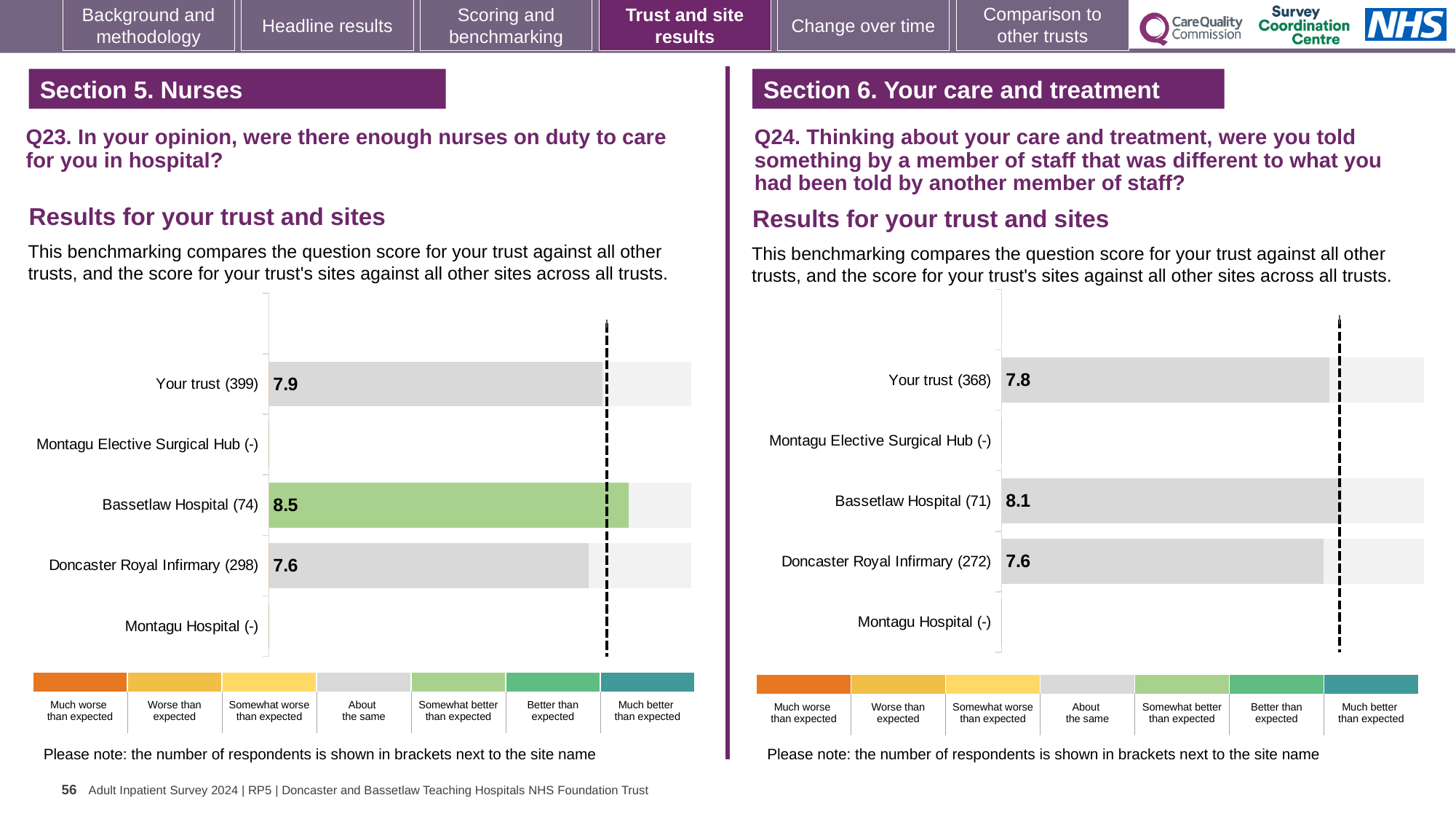
On the Q24 chart (right), what is the difference between the Your trust score and the Bassetlaw Hospital score? 0.3 On the Q23 chart (left), what is the score for Bassetlaw Hospital? 8.5 On the Q24 chart (right), which site has the lowest score among those with a value shown? Doncaster Royal Infirmary On the Q23 chart (left), which site has the highest score? Bassetlaw Hospital On the Q23 chart (left), what is the score for Your trust? 7.9 How many site rows (including Your trust) are listed on the Q24 chart (right)? 5 On the Q23 chart (left), which is larger: the score for Your trust or the score for Doncaster Royal Infirmary? Your trust What type of chart is used on the Q23 chart (left)? Bar chart On the Q23 chart (left), which site's bar is coloured green, indicating 'Somewhat better than expected'? Bassetlaw Hospital On the Q24 chart (right), what is the score for Doncaster Royal Infirmary? 7.6 On the Q23 chart (left), what is the difference between the Bassetlaw Hospital score and the Doncaster Royal Infirmary score? 0.9 On the Q24 chart (right), what is the score for Bassetlaw Hospital? 8.1